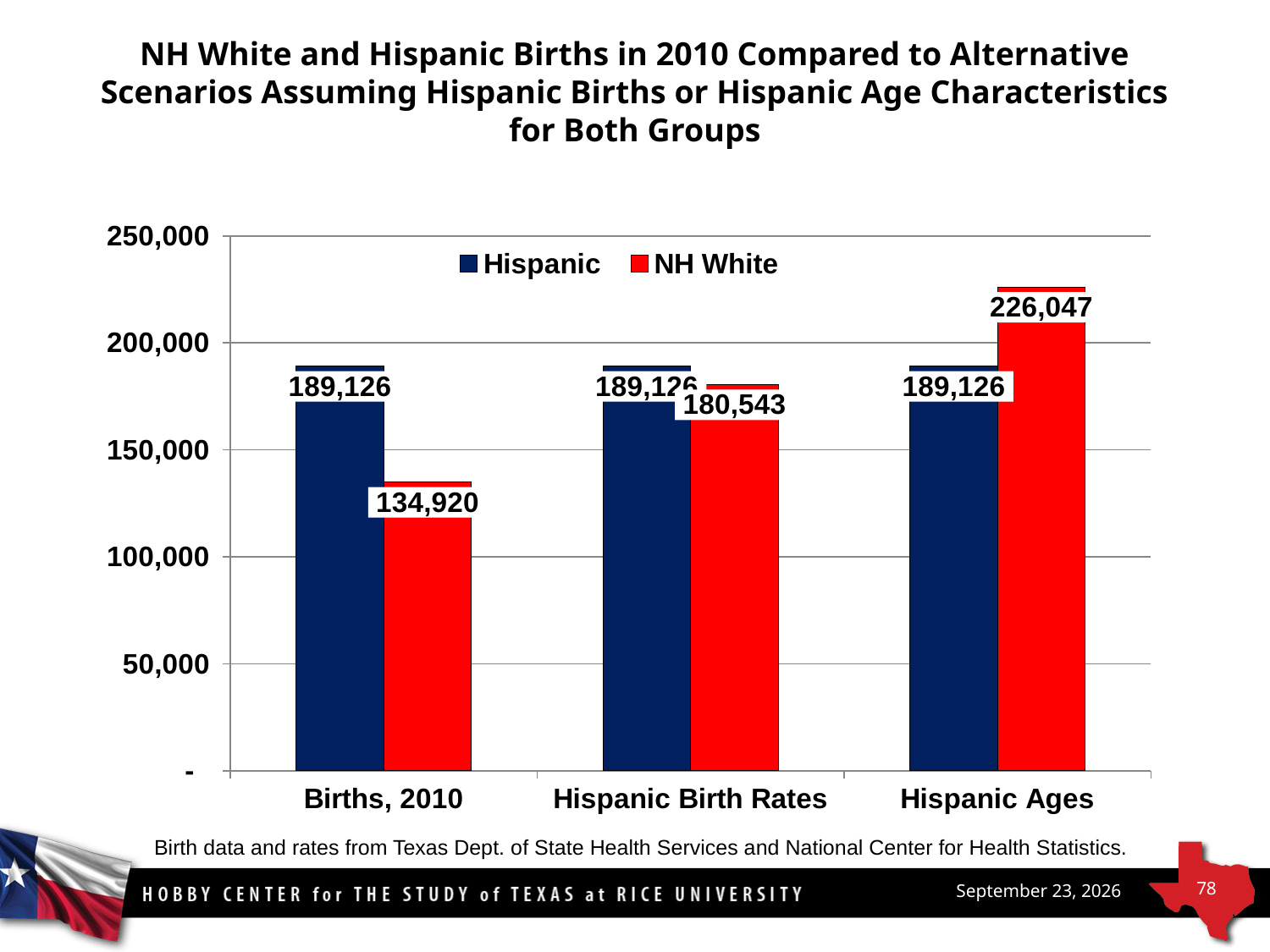
What is the Hispanic value for Births, 2010? 189,126 In which category is the NH White value lowest? Births, 2010 In which category is the NH White value highest? Hispanic Ages What kind of chart is shown on the slide? bar chart Is the NH White value for Hispanic Ages greater or less than 200,000? greater How many categories are shown on the x axis? 3 What is the NH White value for the Hispanic Ages scenario? 226,047 What is the difference between the Hispanic and NH White values for Births, 2010? 54,206 What is the NH White value for the Hispanic Birth Rates scenario? 180,543 Which is larger in the Hispanic Ages scenario, the Hispanic value or the NH White value? NH White What is the NH White value for Births, 2010? 134,920 How many series does the legend list? 2